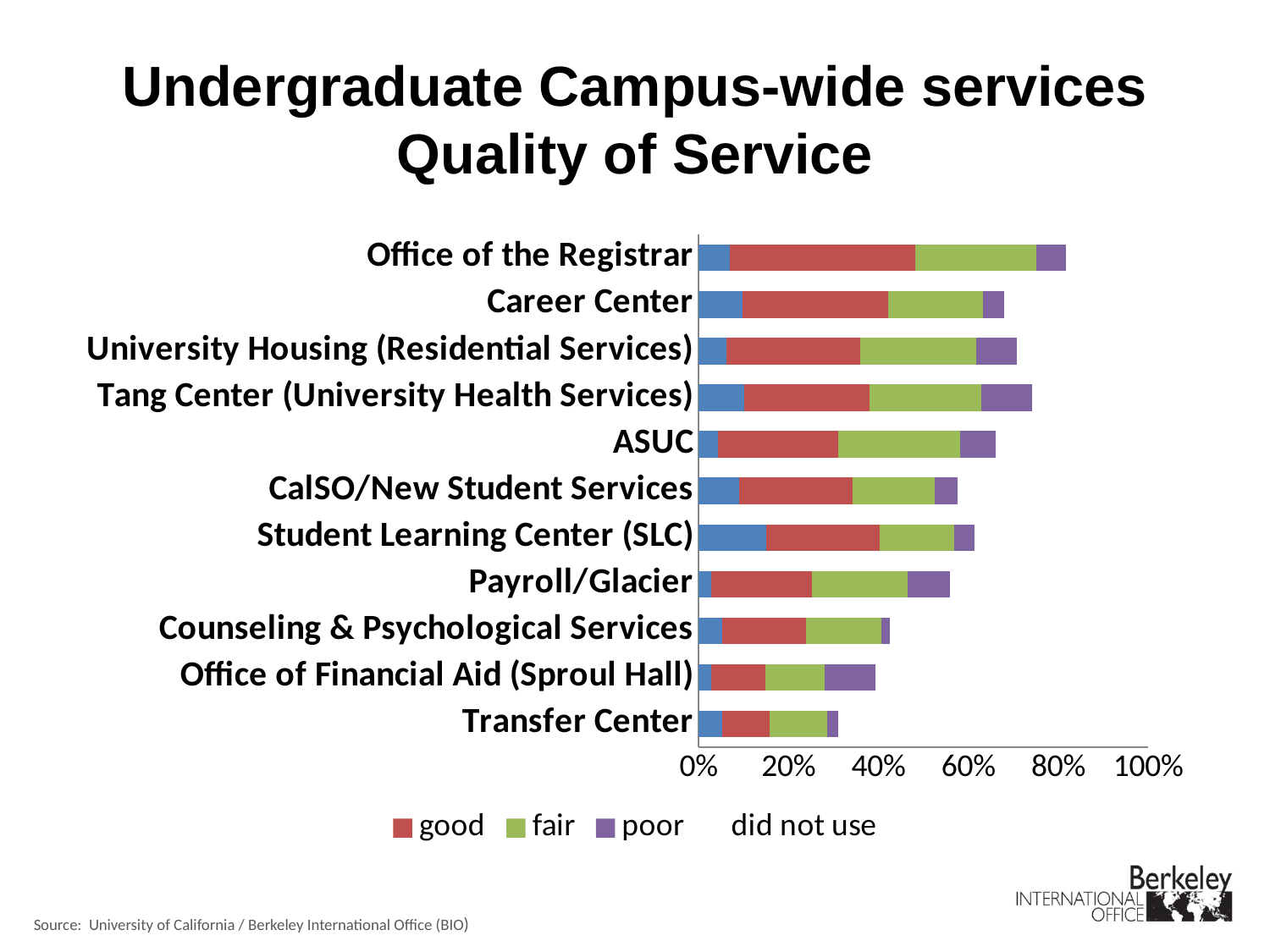
Which service has the longest total bar on the chart? Office of the Registrar Which has the longer total bar, Career Center or Payroll/Glacier? Career Center How many campus services are listed as categories on the chart? 11 What kind of chart is shown on the slide? Stacked bar chart Is the total bar for Tang Center (University Health Services) greater or less than 60%? greater Is the total bar for Payroll/Glacier greater or less than 60%? less Is the total bar for Career Center greater or less than 60%? greater Which has the longer total bar, Office of the Registrar or Transfer Center? Office of the Registrar Which service has the shortest total bar on the chart? Transfer Center What is the first entry listed in the chart legend? good How many series does the legend list? 4